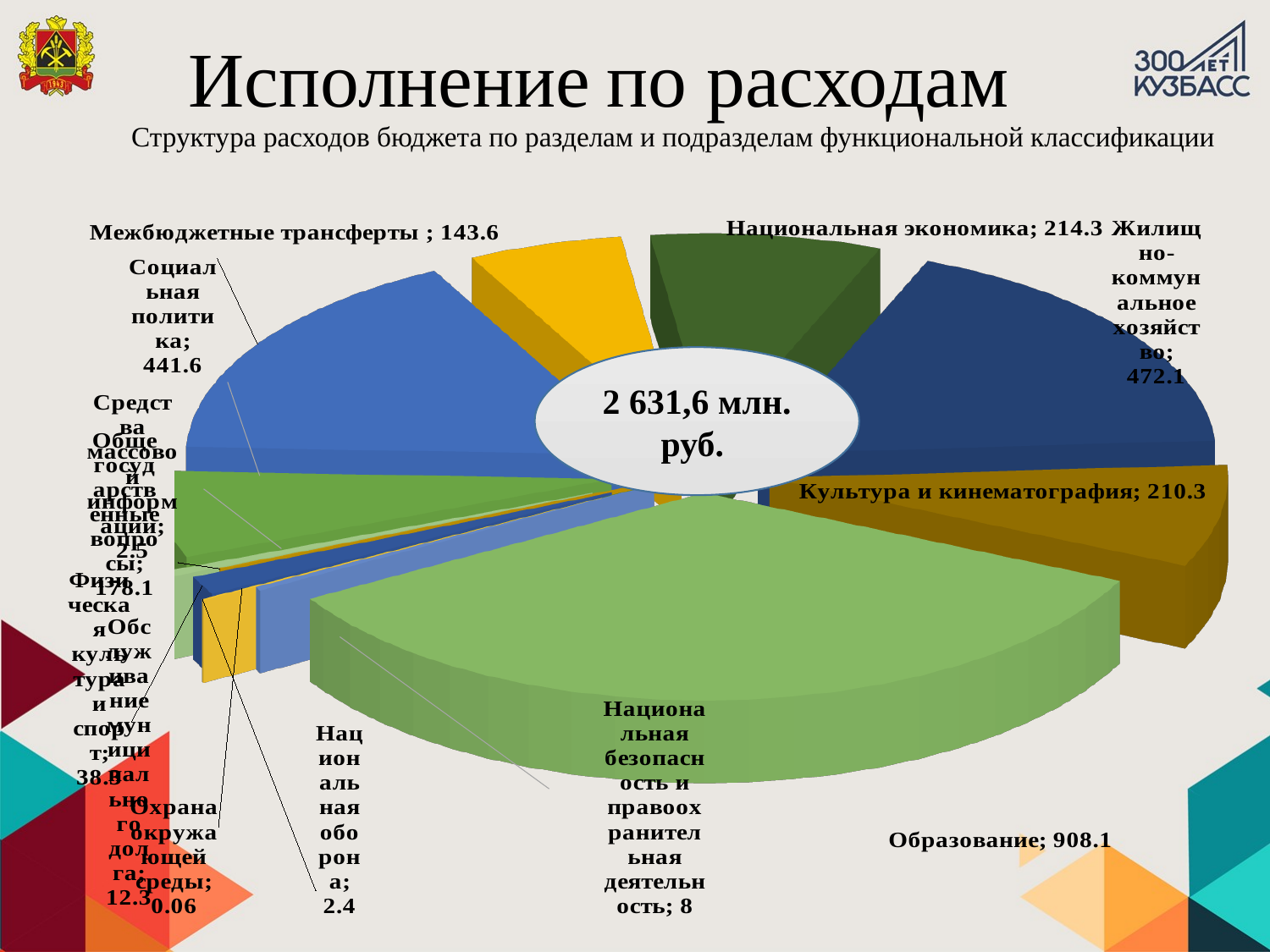
What is the value for Межбюджетные трансферты? 143.6 What is the value for Национальная оборона? 2.4 Which is larger, Национальная экономика or Культура и кинематография? Национальная экономика What is the value for Образование? 908.1 What total is shown in the centre of the chart? 2 631,6 млн. руб. Which category has the largest slice? Образование What is the value for Социальная политика? 441.6 What kind of chart is shown on the slide? pie chart What is the difference between Образование and Жилищно-коммунальное хозяйство? 436 What is the value for Жилищно-коммунальное хозяйство? 472.1 Which category has the smallest value? Охрана окружающей среды What is the value for Национальная безопасность и правоохранительная деятельность? 8